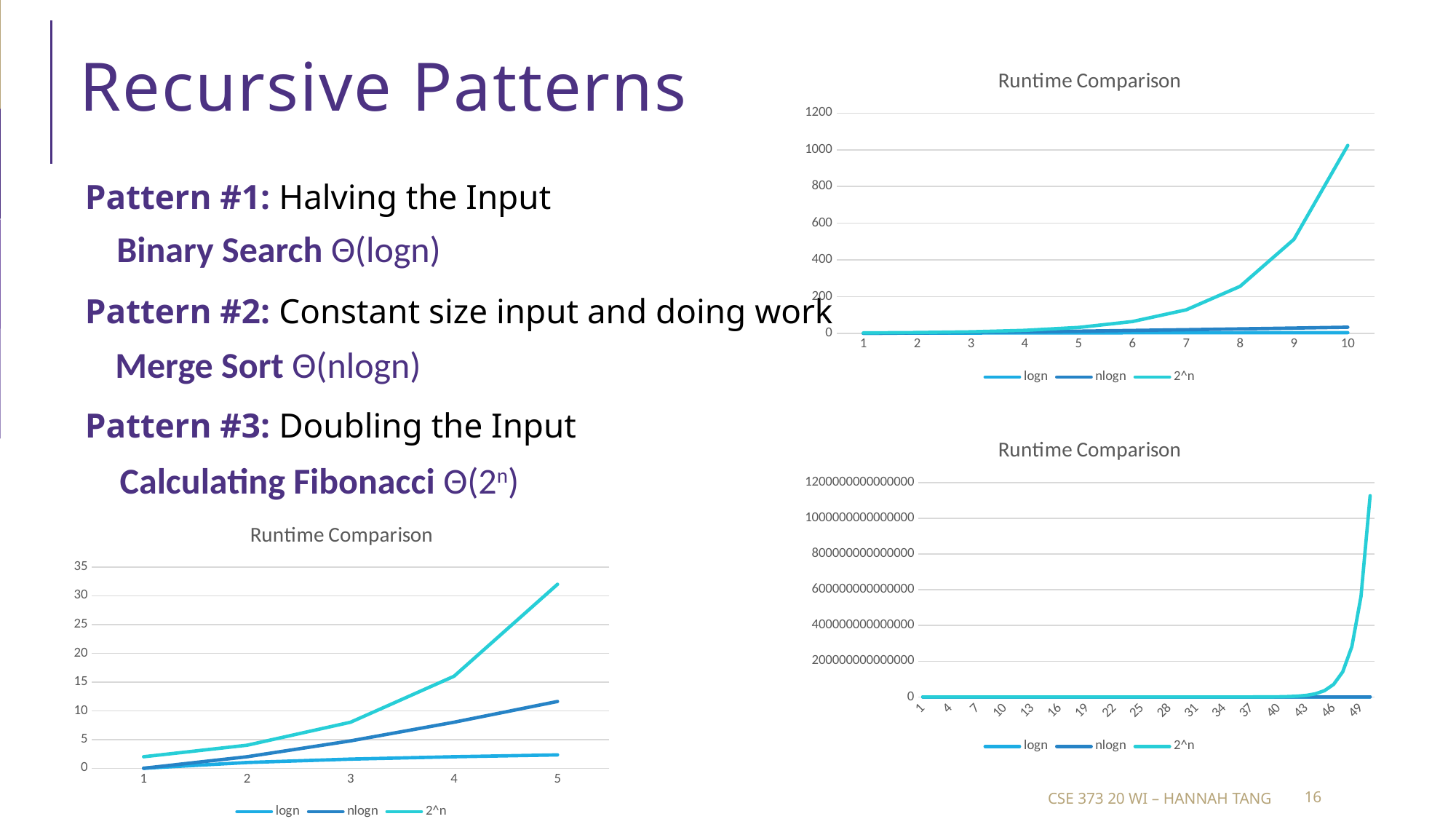
How many series does the legend of the top-right chart list? 3 In the bottom-left chart, is the value of nlogn at x = 5 greater or less than 10? greater In the bottom-left chart, is the value of logn at x = 5 greater or less than 5? less In the top-right chart, which series reaches the highest value at x = 10? 2^n How many x-axis categories does the top-right chart show? 10 In the bottom-left chart, is the value of 2^n at x = 5 greater or less than 30? greater How many x-axis categories does the bottom-left chart show? 5 In the bottom-right chart, does the 2^n series rise or fall as x increases? rise What kind of chart is the bottom-left chart? line chart In the bottom-left chart, which series has the larger value at x = 5, 2^n or nlogn? 2^n What are the legend entries of the bottom-right chart? logn, nlogn, 2^n